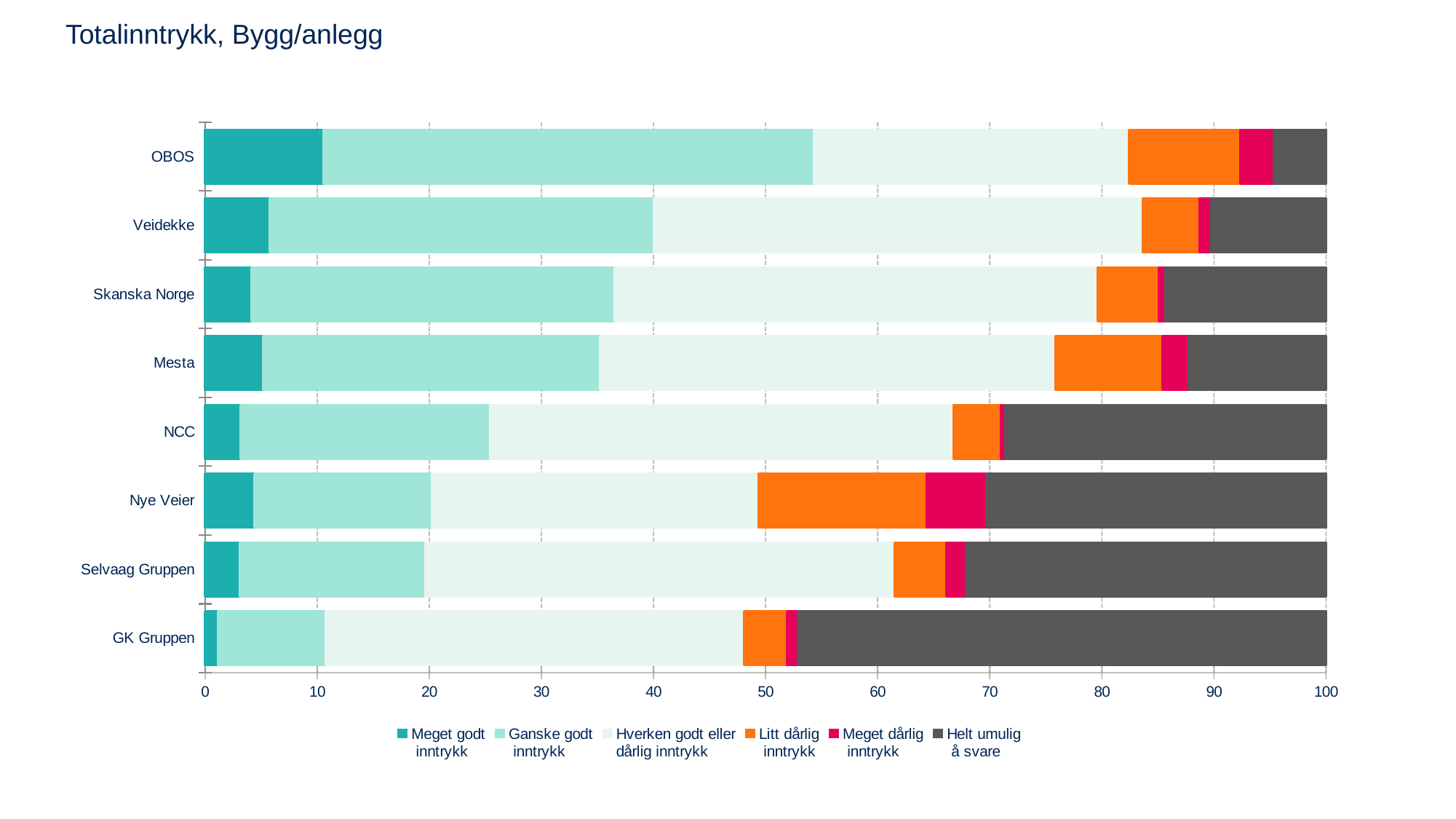
Which company has the largest 'Litt dårlig inntrykk' segment? Nye Veier Which company has the largest 'Meget godt inntrykk' segment? OBOS How many companies are listed on the vertical axis of the chart? 8 How many series does the legend list? 6 Which has a larger 'Helt umulig å svare' segment, NCC or Mesta? NCC Which company has the largest 'Helt umulig å svare' segment? GK Gruppen Which company has the smallest 'Helt umulig å svare' segment? OBOS Which legend entry is shown in dark grey? Helt umulig å svare Is the 'Ganske godt inntrykk' value for OBOS greater or less than 40? greater Is the 'Helt umulig å svare' value for GK Gruppen greater or less than 40? greater What is the title of the chart? Totalinntrykk, Bygg/anlegg What kind of chart is shown on the slide? Stacked bar chart